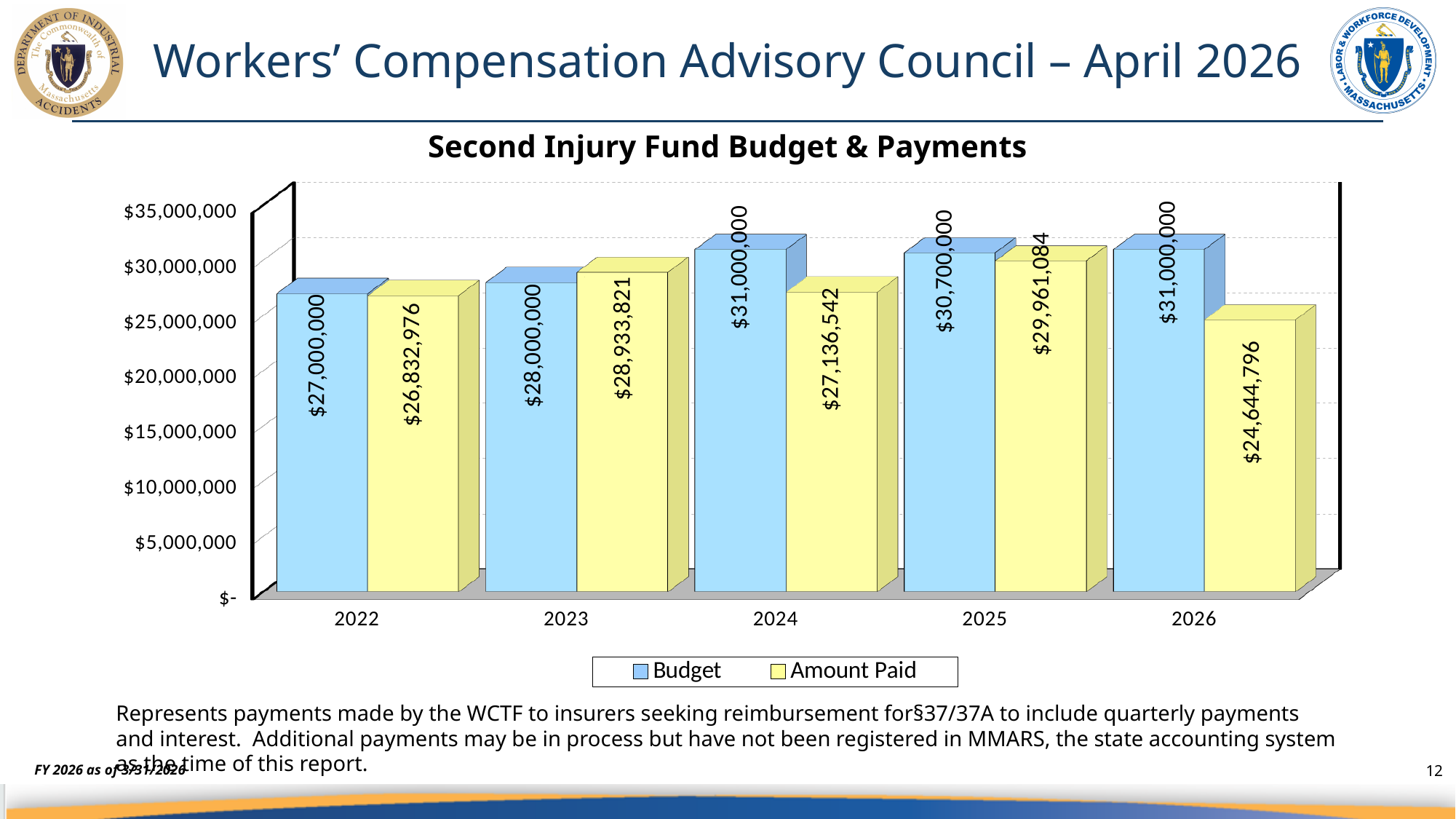
What is the Amount Paid for 2022? $26,832,976 Which year has the lowest Amount Paid? 2026 What kind of chart is shown on the slide? Bar chart How many years are shown on the x axis? 5 What is the title of the chart? Second Injury Fund Budget & Payments What is the Budget value for 2024? $31,000,000 Which year has the highest Amount Paid? 2025 In 2023, which is larger, the Budget or the Amount Paid? Amount Paid What is the Amount Paid for 2025? $29,961,084 Which year has the lowest Budget? 2022 What is the difference between the Budget and the Amount Paid in 2026? $6,355,204 How many series does the legend list? 2